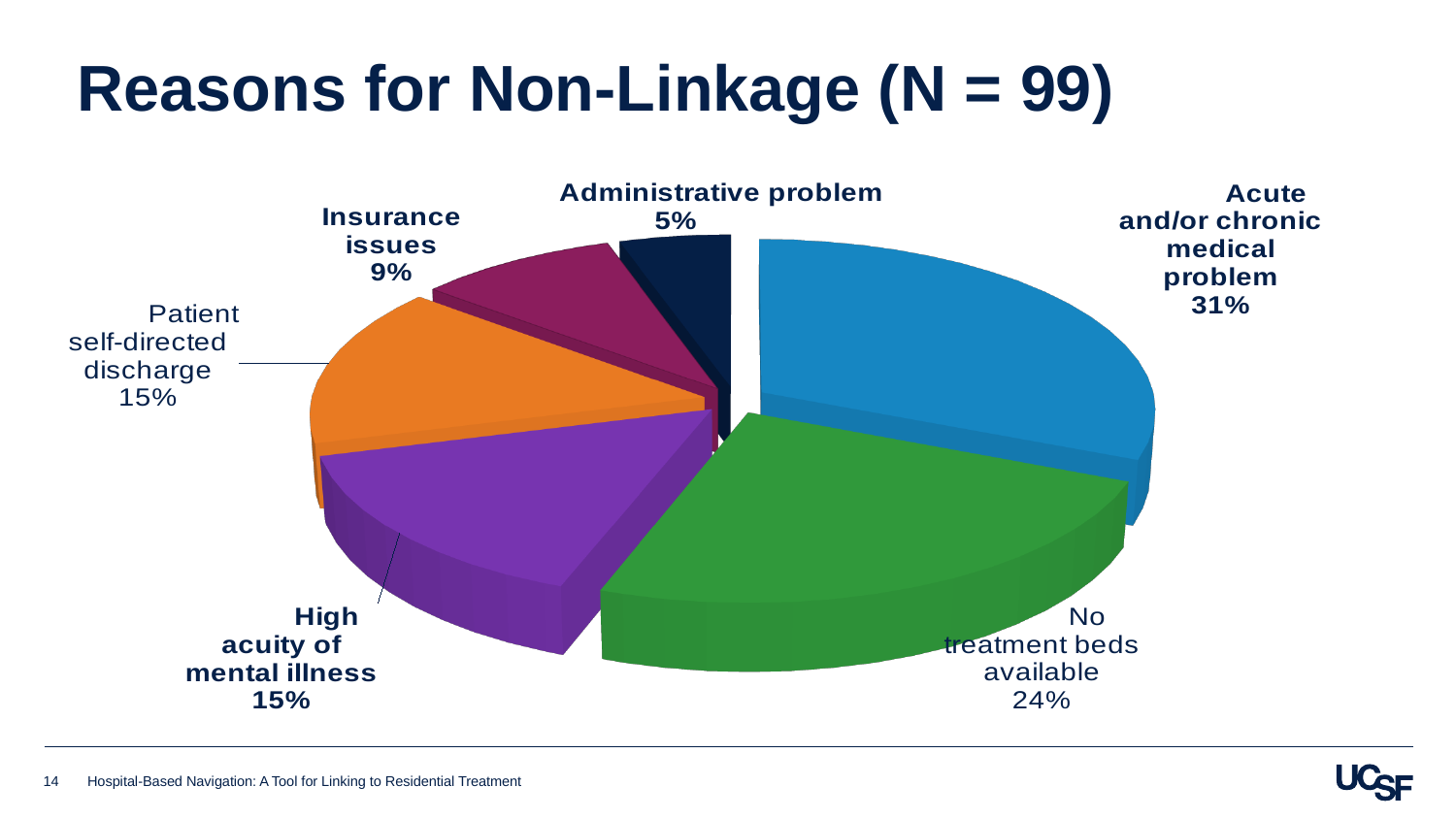
Which is larger, the share for 'Insurance issues' or the share for 'High acuity of mental illness'? High acuity of mental illness What kind of chart is shown on the slide? Pie chart What percentage is shown for 'Patient self-directed discharge'? 15% What share of the pie is 'Acute and/or chronic medical problem'? 31% Which reason for non-linkage has the largest share of the pie? Acute and/or chronic medical problem How many slices does the pie chart have? 6 What is the difference in percentage points between 'Acute and/or chronic medical problem' and 'No treatment beds available'? 7 percentage points What is the title of the chart on the slide? Reasons for Non-Linkage (N = 99) Which reason for non-linkage has the smallest share of the pie? Administrative problem What share of the pie is 'No treatment beds available'? 24% What percentage is shown for 'Insurance issues'? 9% What percentage is shown for 'Administrative problem'? 5%